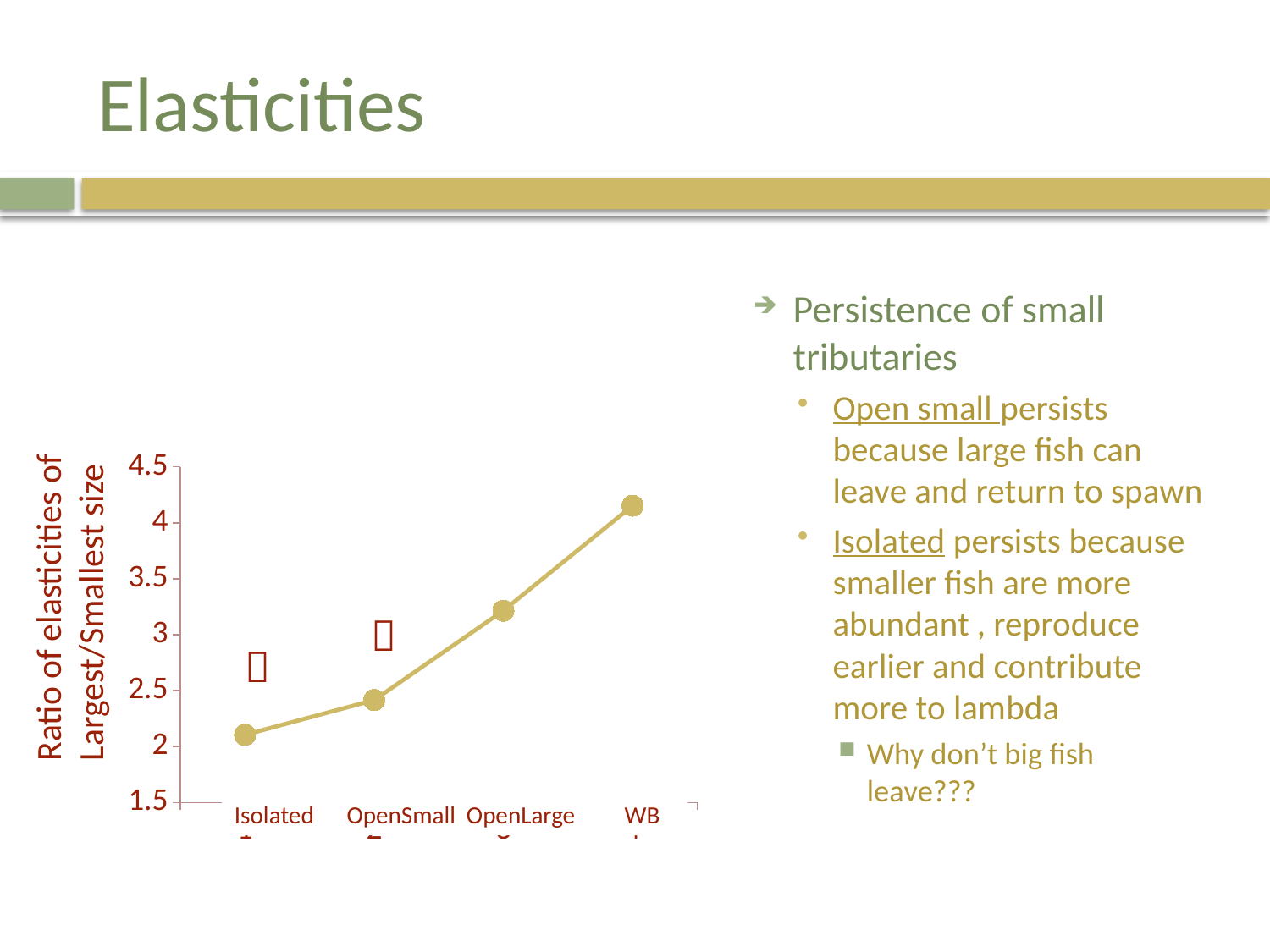
What is the label on the vertical axis of the chart? Ratio of elasticities of Largest/Smallest size Is the value for OpenLarge greater or less than 3.5? less Is the value for OpenSmall greater or less than 3? less Which category has the highest ratio of elasticities? WB Is the value for Isolated greater or less than 2.5? less Do the values rise or fall moving from Isolated to WB along the x axis? rise Which has the larger value, WB or Isolated? WB Which category has the lowest ratio of elasticities? Isolated What kind of chart is shown on the slide? line chart Which has the larger value, OpenLarge or OpenSmall? OpenLarge How many categories are plotted along the x axis of the chart? 4